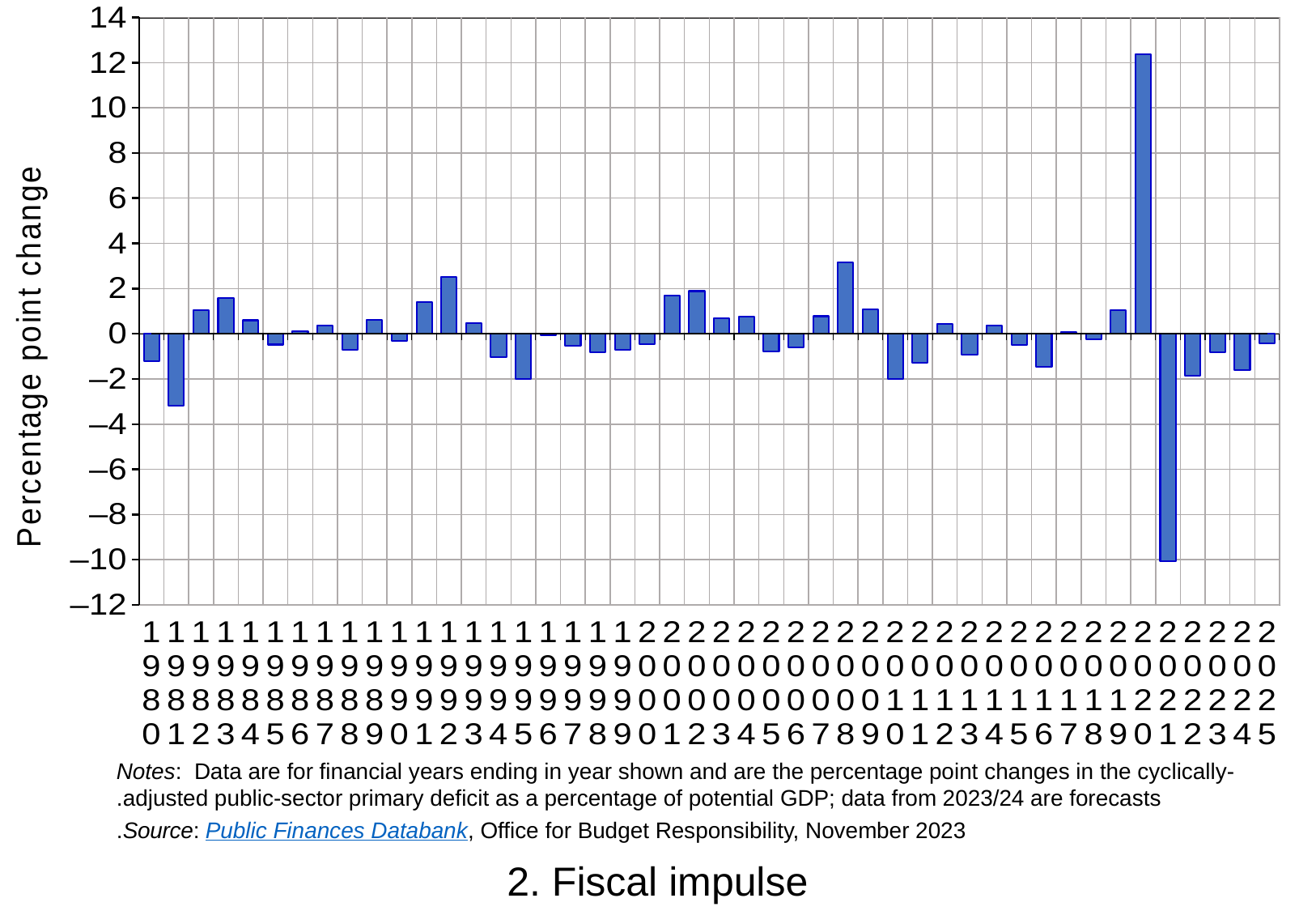
Which year has the lowest value on the chart? 2021 How many years (bars) are plotted on the chart? 46 What is the title of the chart? 2. Fiscal impulse Which year has the larger value, 2008 or 2020? 2020 Is the value for 2021 greater or less than -8? less Is the value for 2020 greater or less than 10? greater What is the label on the vertical axis of the chart? Percentage point change Which year has the highest value on the chart? 2020 Which year has the larger value, 1991 or 1992? 1992 Is the value for 2008 greater or less than 2? greater What kind of chart is shown on the slide? bar chart